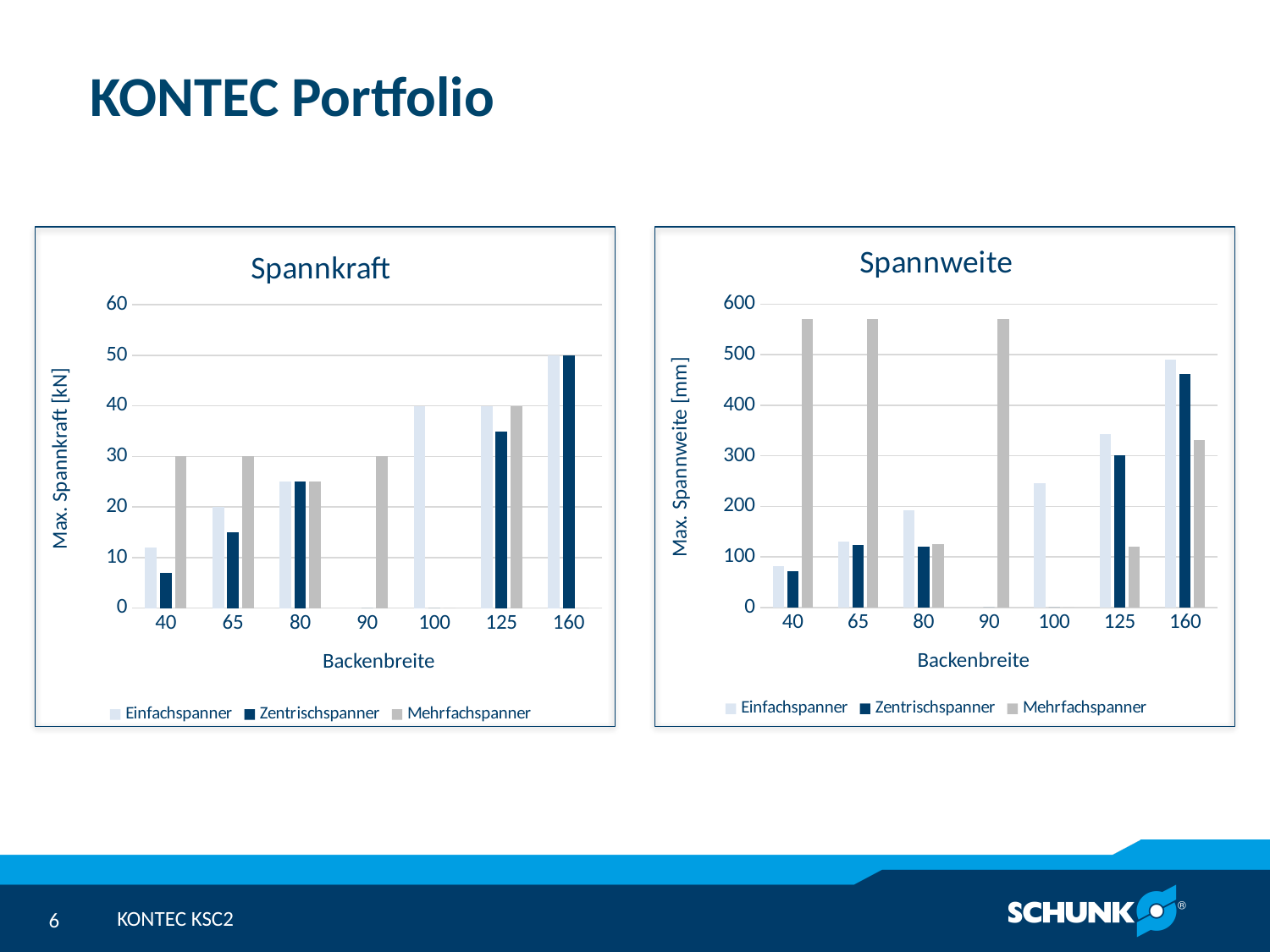
In the Spannkraft chart, what is the value for Einfachspanner at Backenbreite 100? 40 In the Spannweite chart, is the Einfachspanner value at Backenbreite 100 greater or less than 200? greater In the Spannkraft chart, what is the value for Zentrischspanner at Backenbreite 160? 50 In the Spannkraft chart, which Backenbreite has the highest Zentrischspanner value? 160 In the Spannkraft chart, is the Zentrischspanner value at Backenbreite 125 greater or less than 30? greater What kind of chart is the Spannkraft chart? bar chart How many series does the legend of the Spannweite chart list? 3 In the Spannkraft chart, what is the value for Einfachspanner at Backenbreite 65? 20 In the Spannkraft chart, what is the value for Mehrfachspanner at Backenbreite 90? 30 In the Spannweite chart, which is larger at Backenbreite 160: Einfachspanner or Mehrfachspanner? Einfachspanner In the Spannweite chart, is the Mehrfachspanner value at Backenbreite 40 greater or less than 500? greater